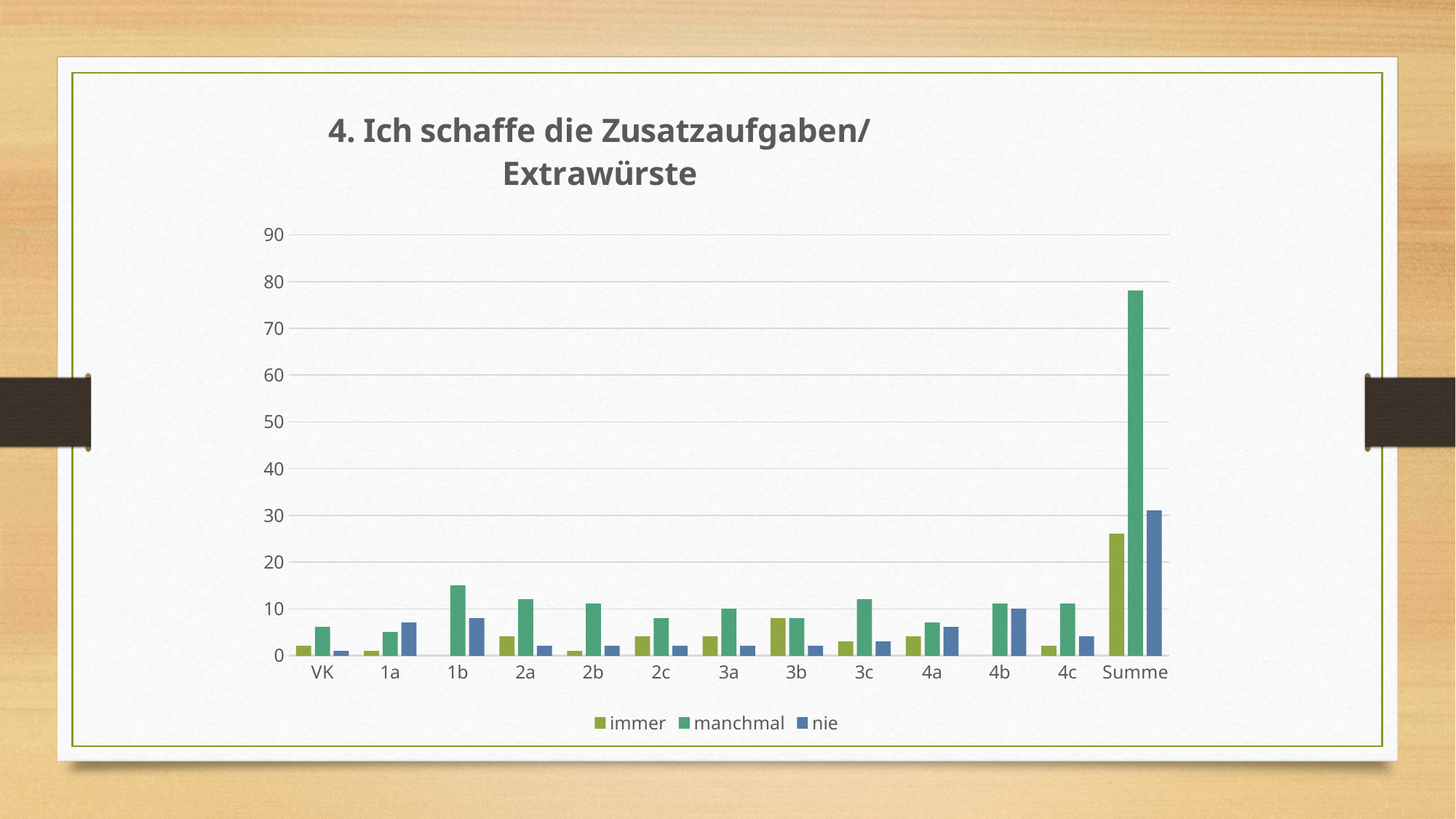
For category 1b, which is larger: the 'manchmal' value or the 'nie' value? manchmal Is the 'manchmal' value for 1b greater or less than 10? greater Is the 'nie' value for Summe greater or less than 20? greater Is the 'immer' value for Summe greater or less than 30? less For category VK, which is larger: the 'manchmal' value or the 'nie' value? manchmal How many categories are shown on the x axis? 13 What kind of chart is shown on the slide? bar chart How many series does the legend list? 3 What is the title of the chart? 4. Ich schaffe die Zusatzaufgaben/ Extrawürste Which category has the highest 'manchmal' bar? Summe